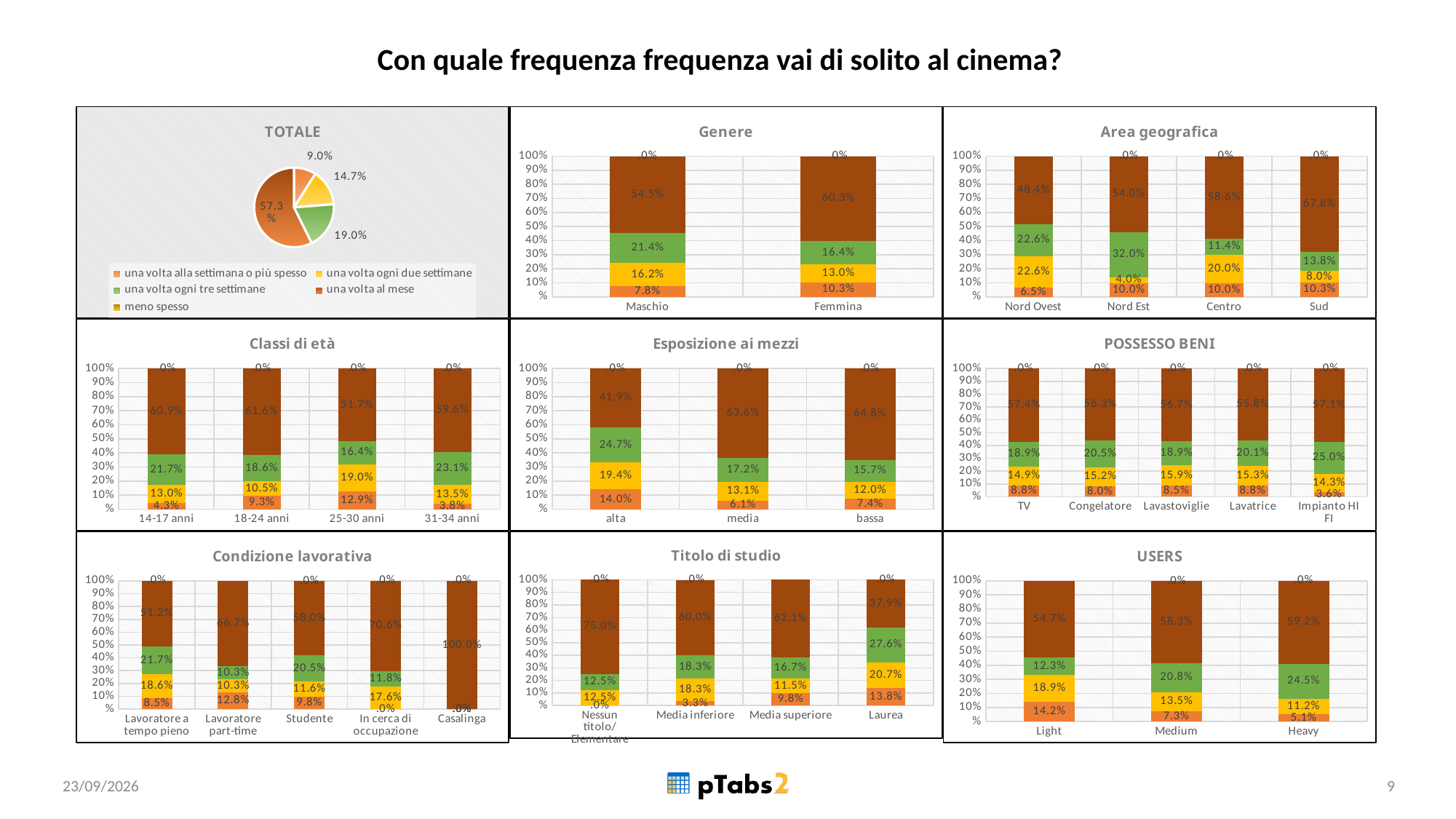
In the Titolo di studio chart, which is larger: the brown segment for Nessun titolo/Elementare or for Laurea? Nessun titolo/Elementare In the Genere chart, what is the value of the brown (una volta al mese) segment for Femmina? 60.3% In the TOTALE pie chart, what is the value of the largest slice? 57.3% In the Condizione lavorativa chart, what is the value shown for Casalinga? 100.0% In the POSSESSO BENI chart, what is the value of the orange (bottom) segment for Impianto HI FI? 3.6% In the Area geografica chart, which category has the highest brown (una volta al mese) segment? Sud In the Classi di età chart, what is the difference between the brown segment values for 18-24 anni and 25-30 anni? 9.9% What kind of chart is the USERS chart? Stacked bar chart How many entries does the legend of the TOTALE chart list? 5 In the TOTALE pie chart, what is the value of the smallest slice? 9.0% In the Area geografica chart, what is the value of the green segment for Nord Est? 32.0% In the Esposizione ai mezzi chart, how many categories are shown on the x axis? 3